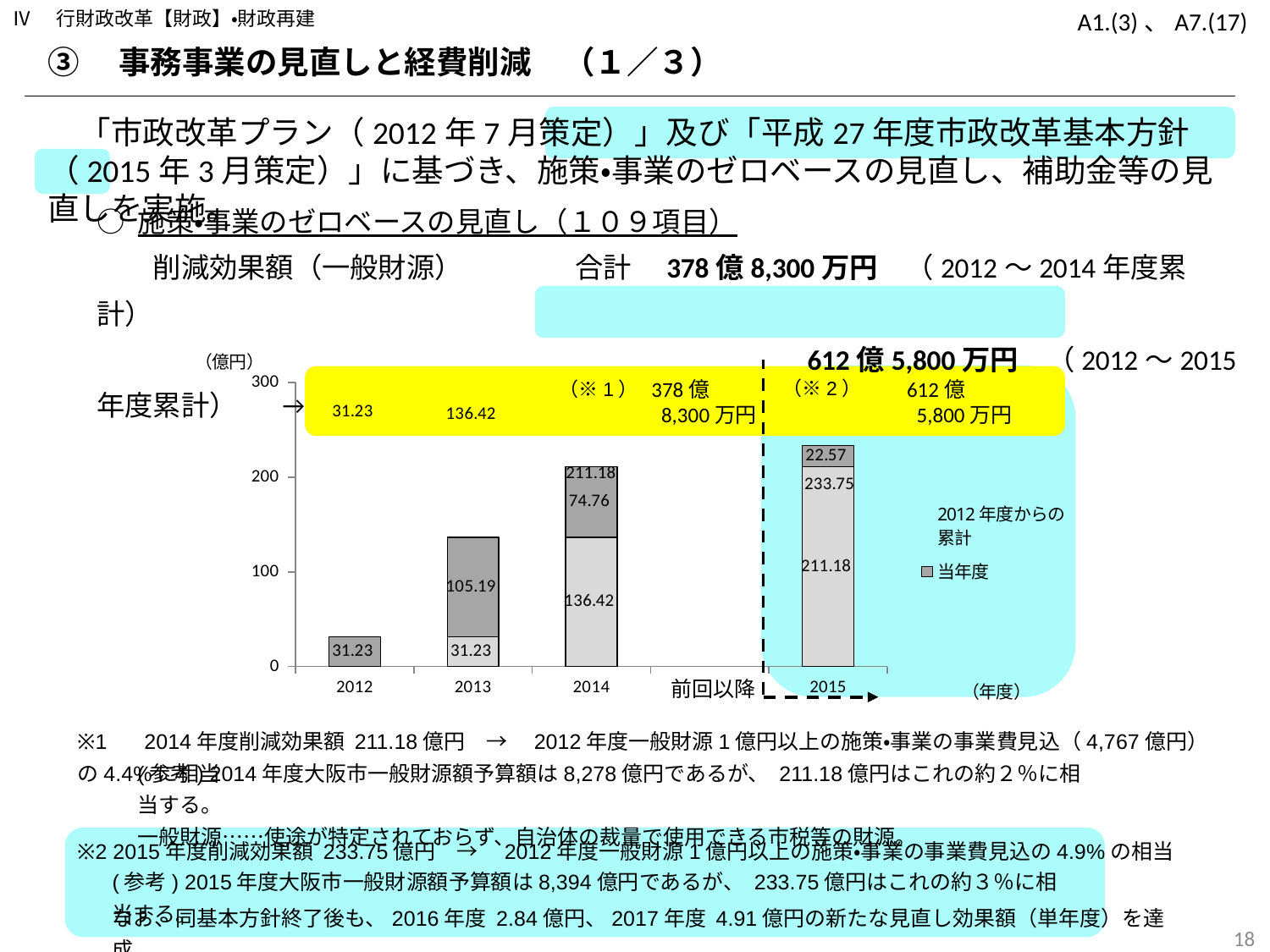
What is the difference between the 当年度 value for 2014 and the 当年度 value for 2015? 52.19 Do the total bar heights rise or fall from 2012 to 2015? rise Which year has the highest total bar? 2015 Which year has the larger 当年度 value, 2013 or 2014? 2013 What is the 当年度 value for 2013? 105.19 Which year has the lowest total bar? 2012 How many series does the chart's legend list? 2 What is the 当年度 value for 2014? 74.76 What is the total of the stacked bar for 2014? 211.18 How many years are shown on the x axis of the chart? 4 What is the 当年度 value for 2015? 22.57 What is the total of the stacked bar for 2015? 233.75